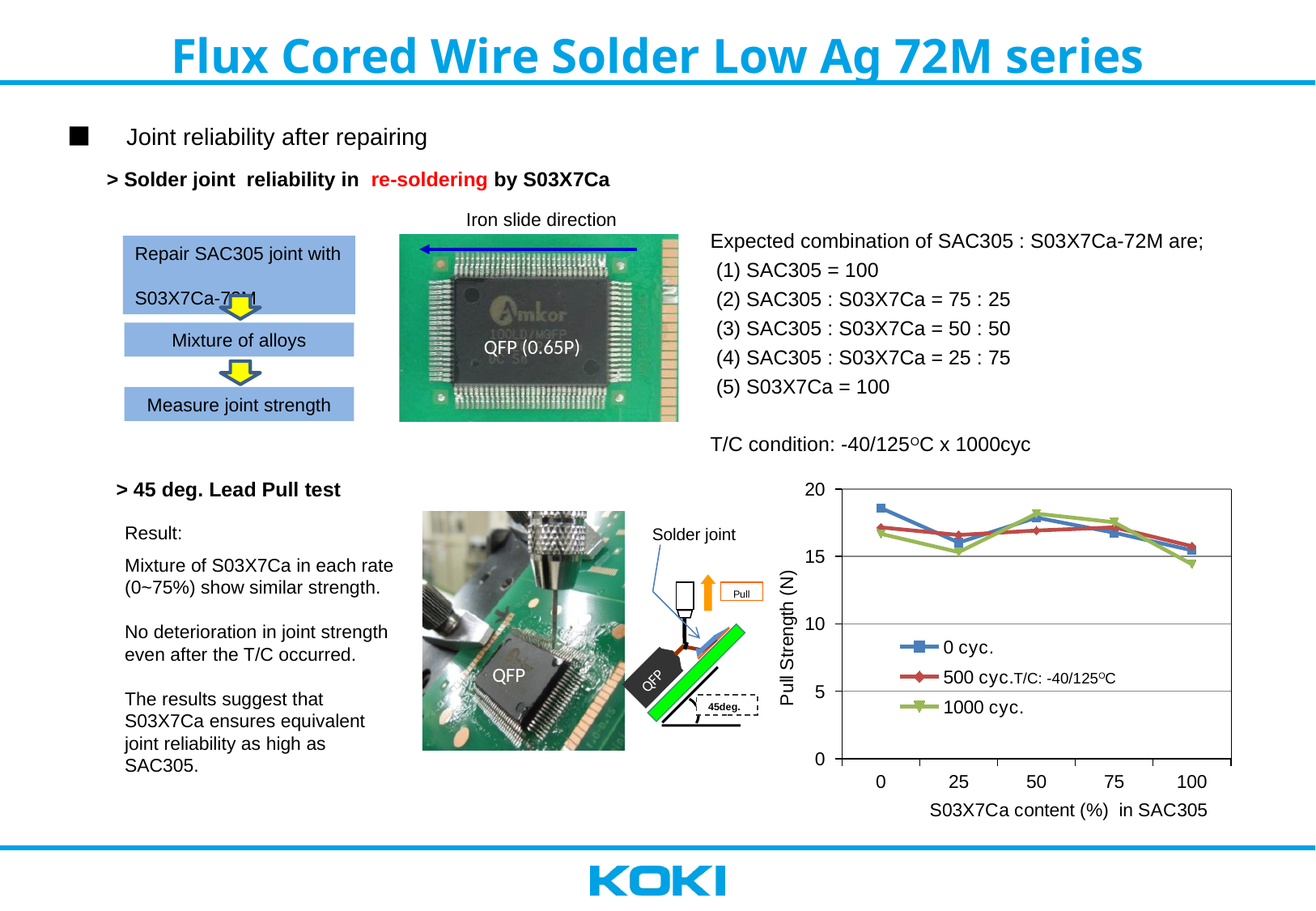
Does the pull strength for the 0 cyc. series overall rise or fall from 0% to 100% S03X7Ca content? fall Is the pull strength for the 1000 cyc. series at 100% S03X7Ca content greater or less than 15? less How many series does the chart legend list? 3 What is the x-axis title of the chart? S03X7Ca content (%) in SAC305 For the 0 cyc. series, at which S03X7Ca content is the pull strength lowest? 100 At 0% S03X7Ca content, which series has the higher pull strength, 0 cyc. or 1000 cyc.? 0 cyc. What is the y-axis title of the chart? Pull Strength (N) How many S03X7Ca content levels are plotted along the x axis of the chart? 5 Is the pull strength for the 0 cyc. series at 0% S03X7Ca content greater or less than 15? greater What kind of chart is shown on the slide? line chart Is the pull strength for the 500 cyc. series at 50% S03X7Ca content greater or less than 10? greater For the 1000 cyc. series, at which S03X7Ca content is the pull strength lowest? 100